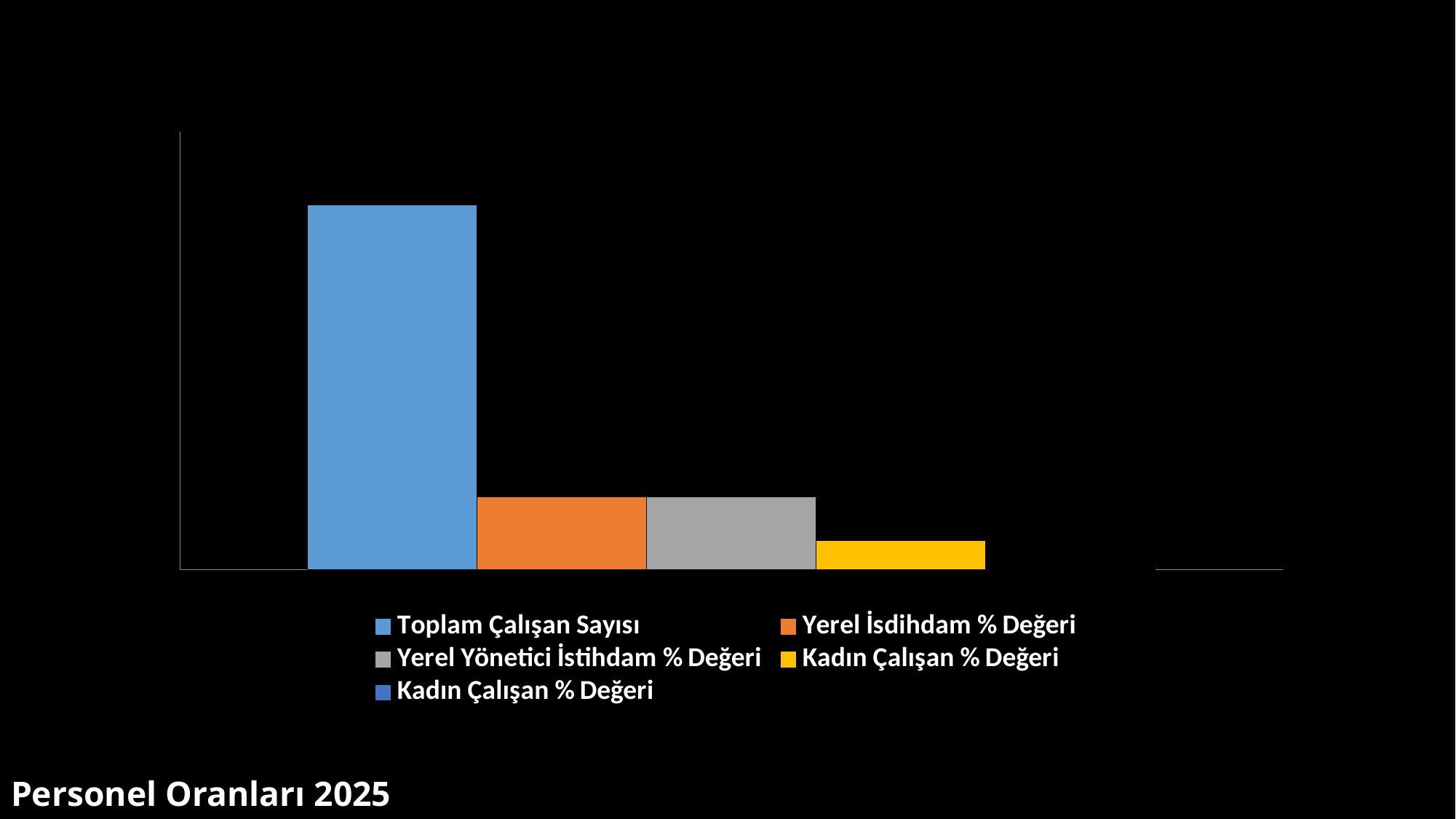
Which series has the tallest bar? Toplam Çalışan Sayısı How many series does the legend list? 5 What is the title shown on the slide? Personel Oranları 2025 How many bars are visible in the chart? 4 Which is larger, the bar for Yerel Yönetici İstihdam % Değeri or the yellow bar for Kadın Çalışan % Değeri? Yerel Yönetici İstihdam % Değeri Which is larger, the bar for Toplam Çalışan Sayısı or the bar for Yerel İsdihdam % Değeri? Toplam Çalışan Sayısı What kind of chart is shown on the slide? bar chart What colour is the bar for Yerel Yönetici İstihdam % Değeri? grey Which series has the shortest visible bar? Kadın Çalışan % Değeri